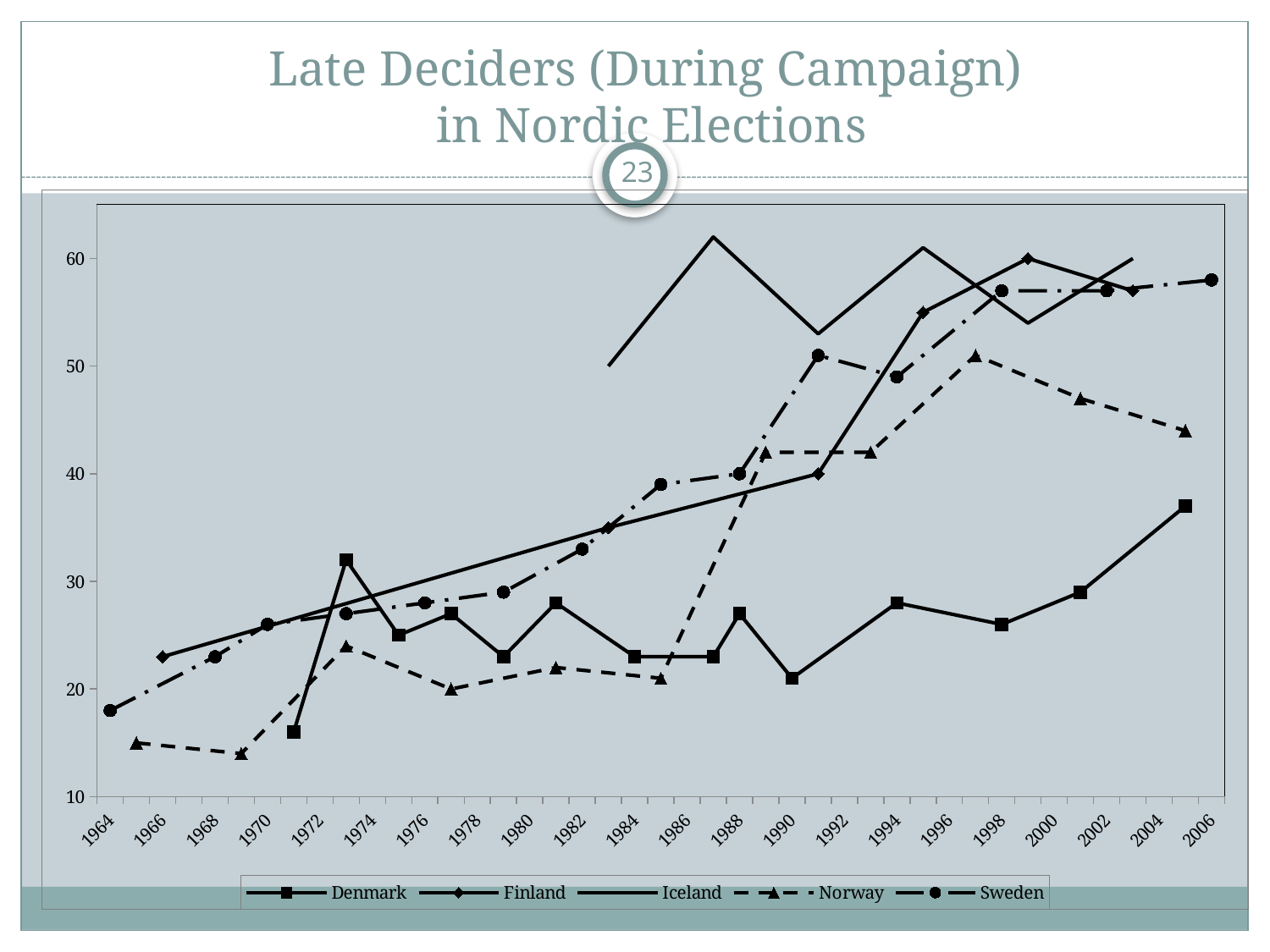
Which countries are listed in the chart legend? Denmark, Finland, Iceland, Norway, Sweden Does the value for Sweden generally rise or fall from 1964 to 2006? rise What is the title of the chart? Late Deciders (During Campaign) in Nordic Elections Is the value for Sweden in 1964 greater or less than 20? less How many series does the legend list? 5 What kind of chart is shown on the slide? line chart Is the value for Sweden in 2006 greater or less than 50? greater